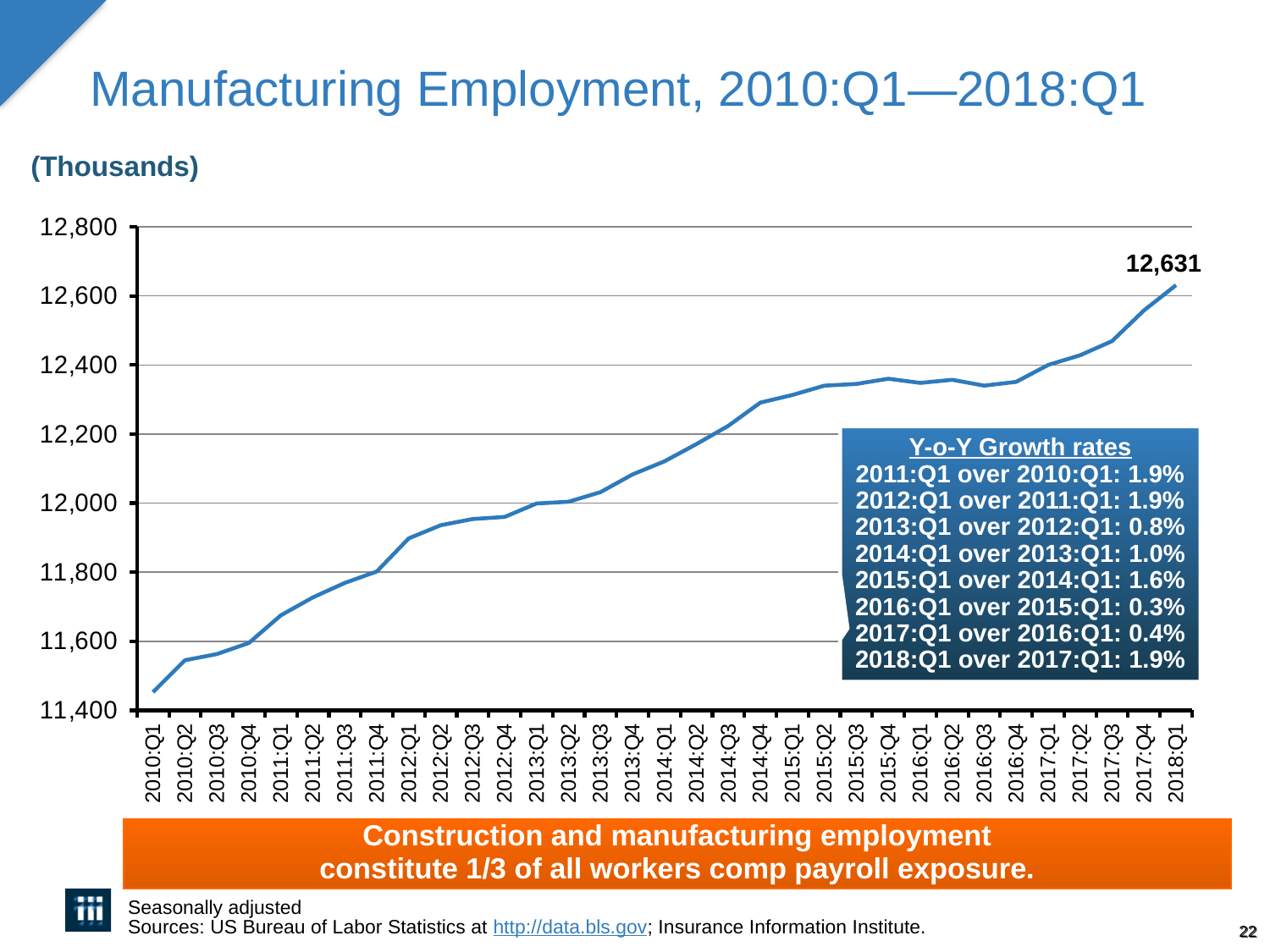
According to the Y-o-Y growth rates box, what was the growth of 2018:Q1 over 2017:Q1? 1.9% What is the value of manufacturing employment shown for 2018:Q1? 12,631 Which is larger, the value for 2015:Q1 or the value for 2013:Q1? 2015:Q1 In what units are the manufacturing employment values expressed? Thousands Which quarter has the highest manufacturing employment on the chart? 2018:Q1 Which quarter has the lowest manufacturing employment on the chart? 2010:Q1 Do the manufacturing employment values generally rise or fall from 2010:Q1 to 2018:Q1? Rise What kind of chart is used to show manufacturing employment on this slide? Line chart Is the value for 2014:Q4 greater or less than 12,200? greater How many quarterly data points are plotted on the chart? 33 Is the value for 2010:Q1 greater or less than 11,600? less Is the value for 2012:Q1 greater or less than 12,000? less